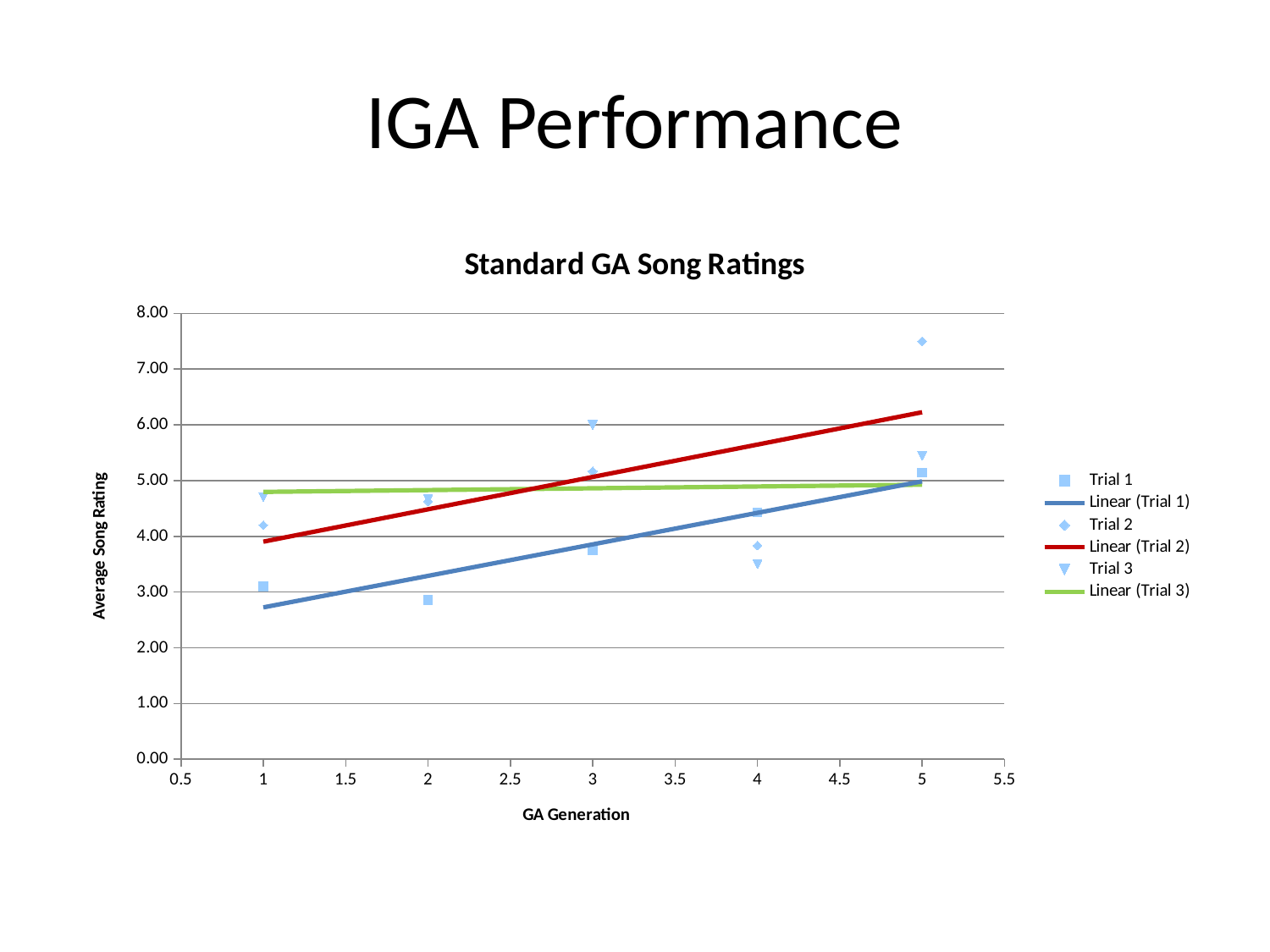
Which trial has the highest plotted point on the chart? Trial 2 Which trial has the lowest plotted point on the chart? Trial 1 What kind of chart is shown on the slide? Scatter chart Is the Trial 1 value at GA generation 4 greater or less than 4.00? greater What is the title of the chart? Standard GA Song Ratings Is the Trial 3 value at GA generation 4 greater or less than 4.00? less Is the Trial 2 value at GA generation 5 greater or less than 7.00? greater How many entries does the chart legend list? 6 Does the Linear (Trial 2) trend line rise or fall as GA generation increases? Rise At GA generation 5, which is larger: the Trial 2 value or the Trial 1 value? Trial 2 How many GA generations are plotted for each trial? 5 What is the label of the vertical axis? Average Song Rating